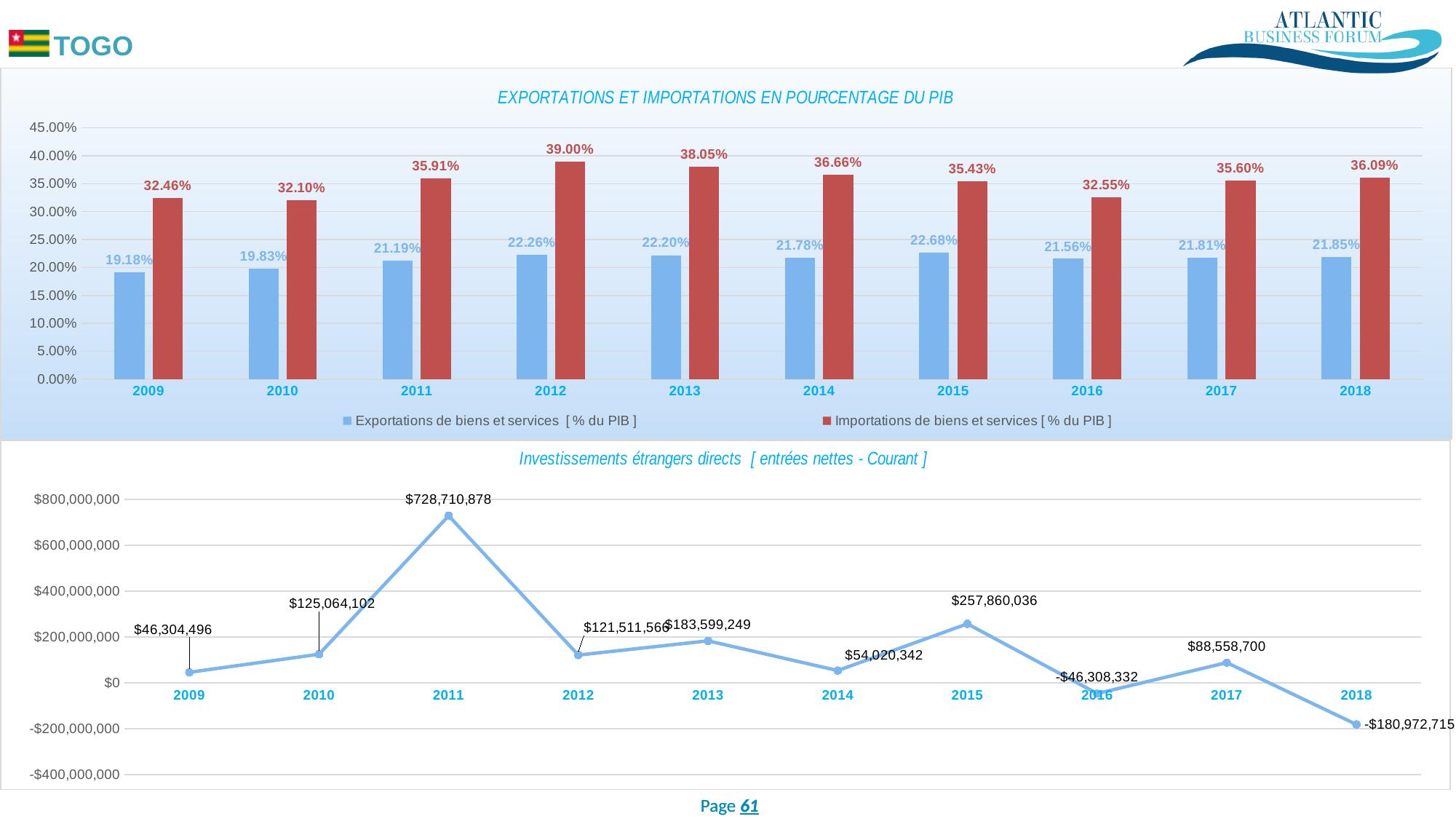
In the bottom chart, what is the value for 2018? -$180,972,715 In the bottom chart, what is the value for 2011? $728,710,878 What kind of chart is the top chart? Bar chart In the top chart, which year has the lowest value for Exportations de biens et services? 2009 In the bottom chart, which year has the lowest value? 2018 In the bottom chart, how many years are plotted? 10 In the top chart, which year has the highest value for Importations de biens et services? 2012 In the top chart, what is the value of Importations de biens et services for 2012? 39.00% In the top chart, what is the value of Exportations de biens et services for 2009? 19.18% In the top chart, what is the difference between Importations and Exportations in 2018? 14.24% In the bottom chart, is the value for 2015 larger or smaller than the value for 2013? Larger In the top chart, how many series does the legend list? 2